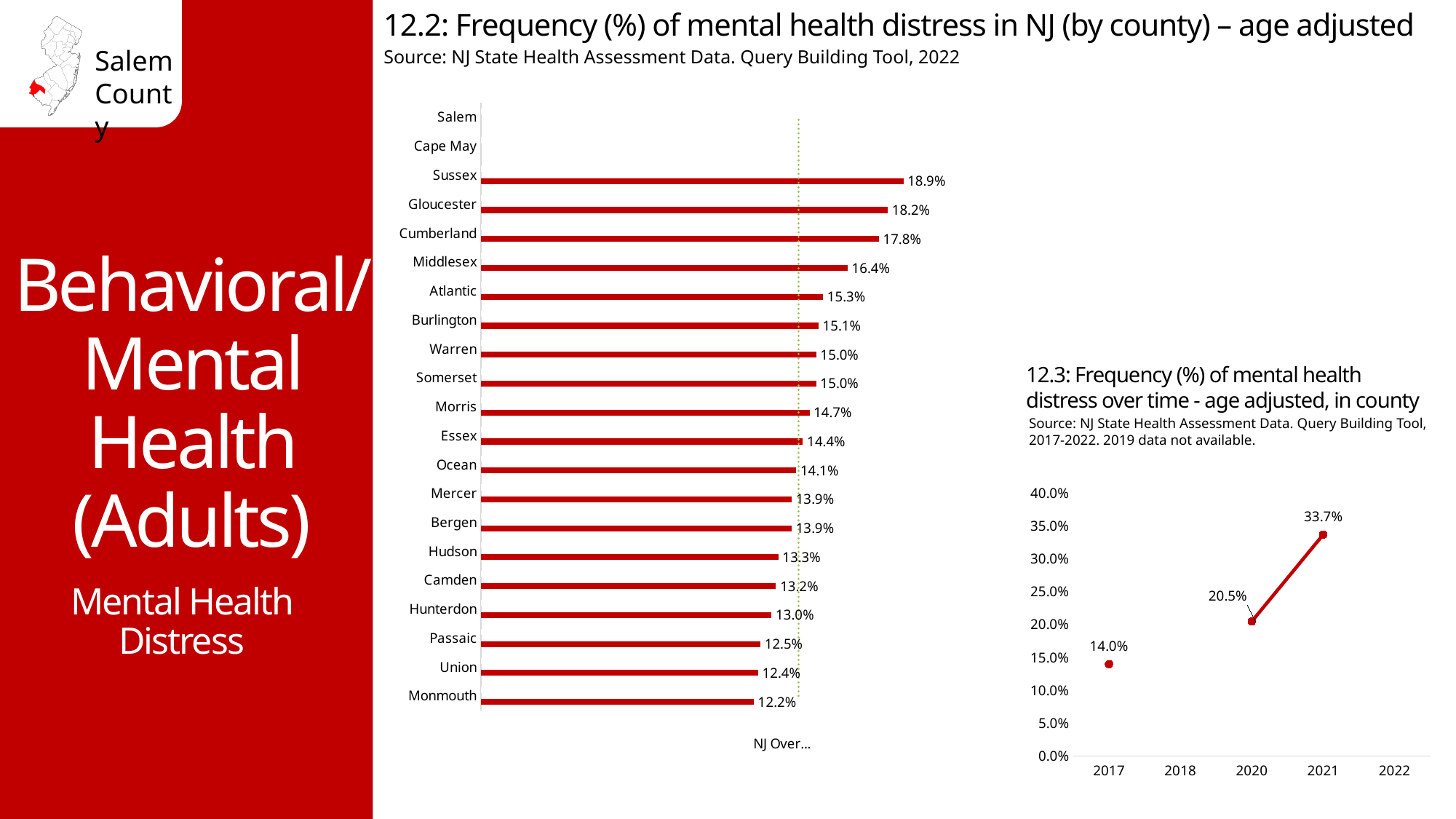
In chart 12.2, what is the difference between the values for Gloucester and Cumberland? 0.4% In chart 12.2, which county has the lowest plotted value? Monmouth In chart 12.2, what is the value for Hunterdon? 13.0% In chart 12.2, which is larger, the value for Middlesex or the value for Atlantic? Middlesex What kind of chart is chart 12.2? Bar chart In chart 12.2, what is the value for Sussex? 18.9% In chart 12.2, what is the value for Monmouth? 12.2% In chart 12.2, which county has the highest plotted value? Sussex In chart 12.3, do the values rise or fall from 2017 to 2021? Rise In chart 12.3, what is the value for 2021? 33.7% In chart 12.3, what is the value for 2017? 14.0% In chart 12.3, what is the difference between the values for 2021 and 2020? 13.2%